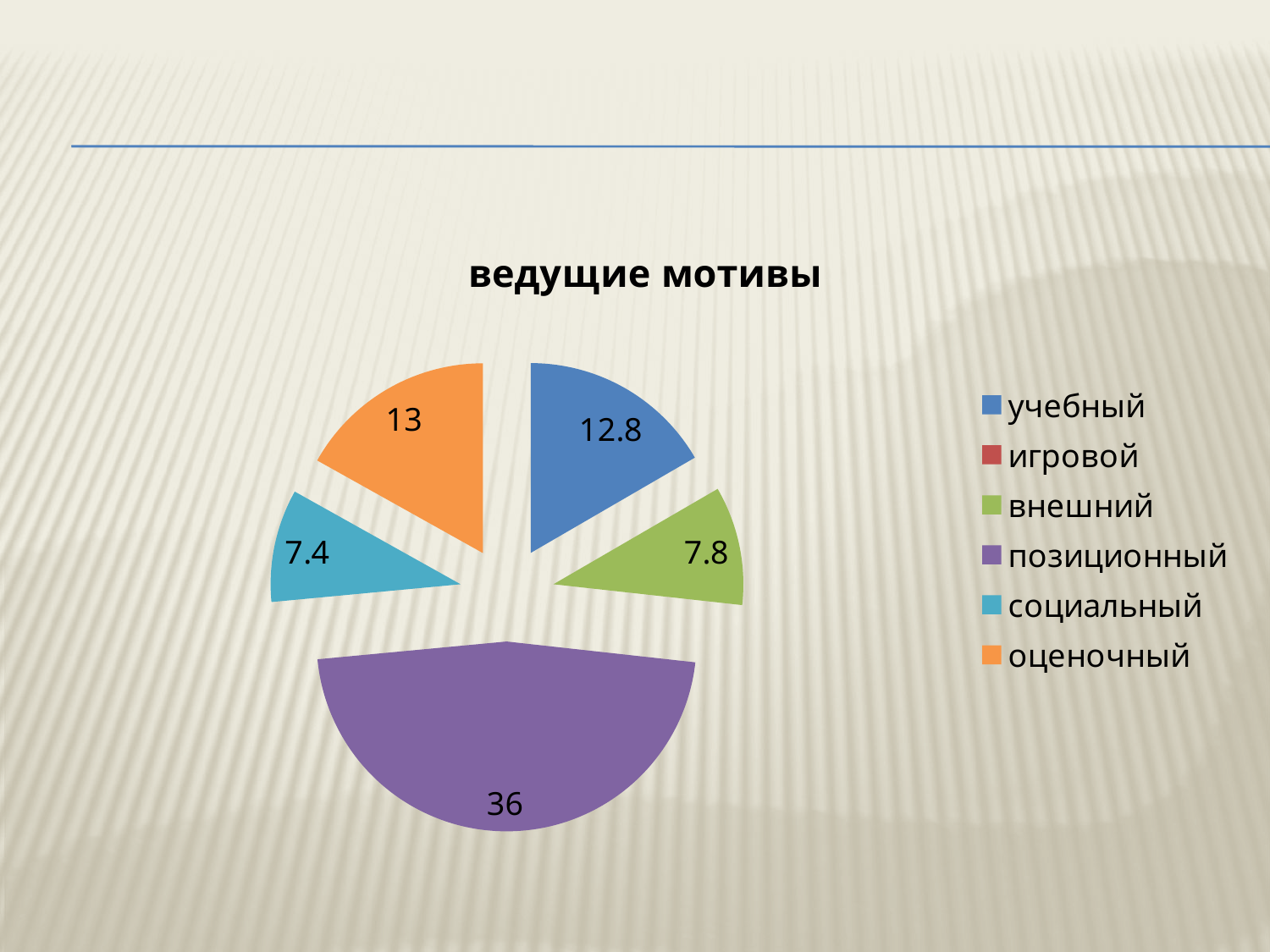
What is the value for позиционный? 36 Which category has the largest slice? позиционный What is the difference between the values for позиционный and оценочный? 23 What is the value for социальный? 7.4 What kind of chart is shown on the slide? pie chart What colour is the slice for позиционный? purple Which is larger, the value for учебный or the value for внешний? учебный How many entries does the legend list? 6 What is the title of the chart? ведущие мотивы What is the value for оценочный? 13 What is the value for учебный? 12.8 Which labelled slice has the smallest value? социальный